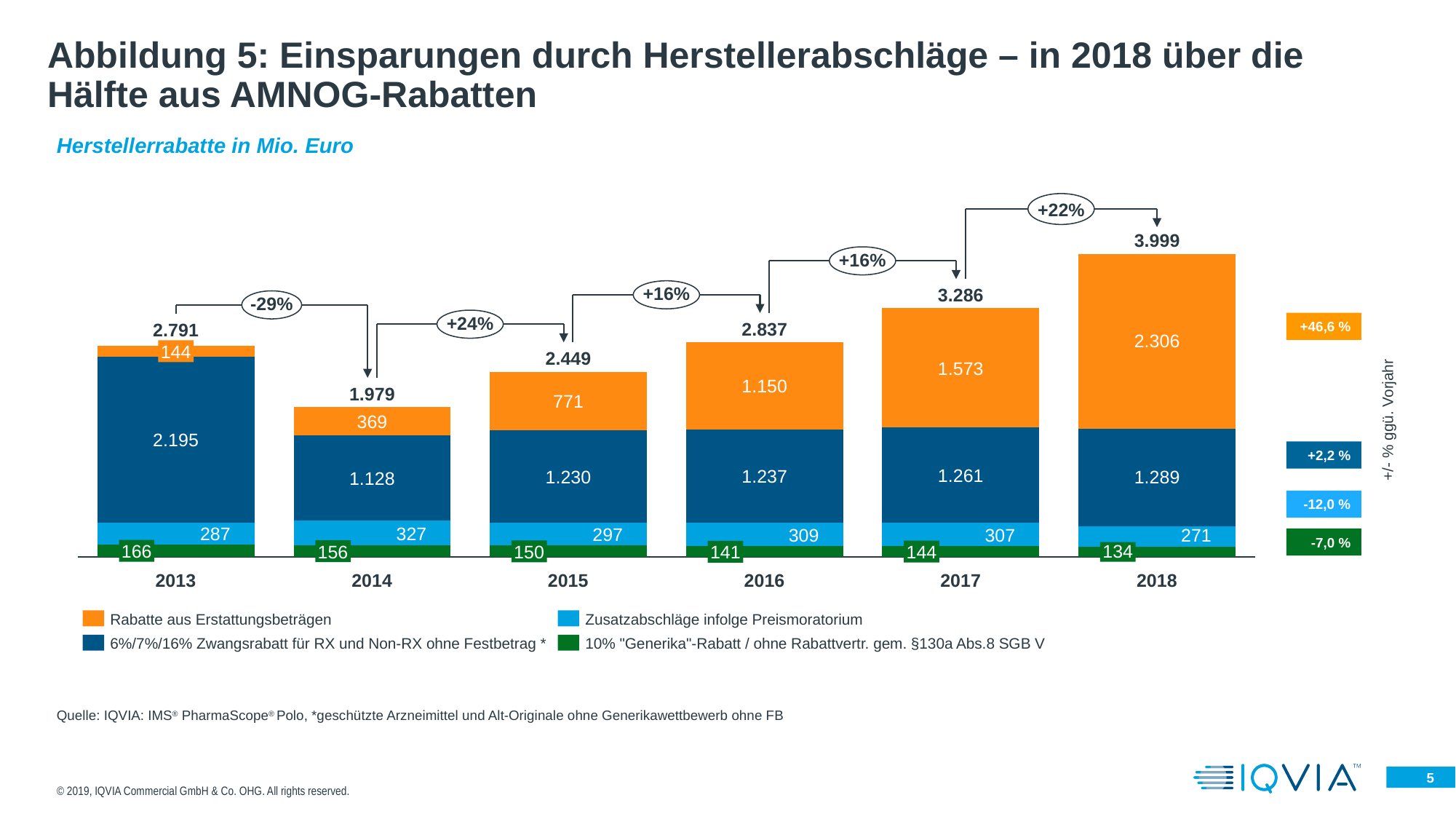
What is the value of 'Zusatzabschläge infolge Preismoratorium' in 2014? 327 Which year has the highest total of manufacturer rebates? 2018 What is the difference between the total for 2018 and the total for 2017? 713 Is the 'Zwangsrabatt' value larger in 2013 or in 2018? 2013 What percentage change from 2017 to 2018 is shown for the 'Rabatte aus Erstattungsbeträgen' series on the right side? +46,6 % What kind of chart is shown? Stacked bar chart How many series does the legend list? 4 What is the value of the '10% "Generika"-Rabatt' segment in 2017? 144 How many years are shown on the x axis? 6 What is the total of the stacked bar for 2018? 3.999 What is the value of 'Rabatte aus Erstattungsbeträgen' in 2016? 1.150 Which year has the lowest total of manufacturer rebates? 2014